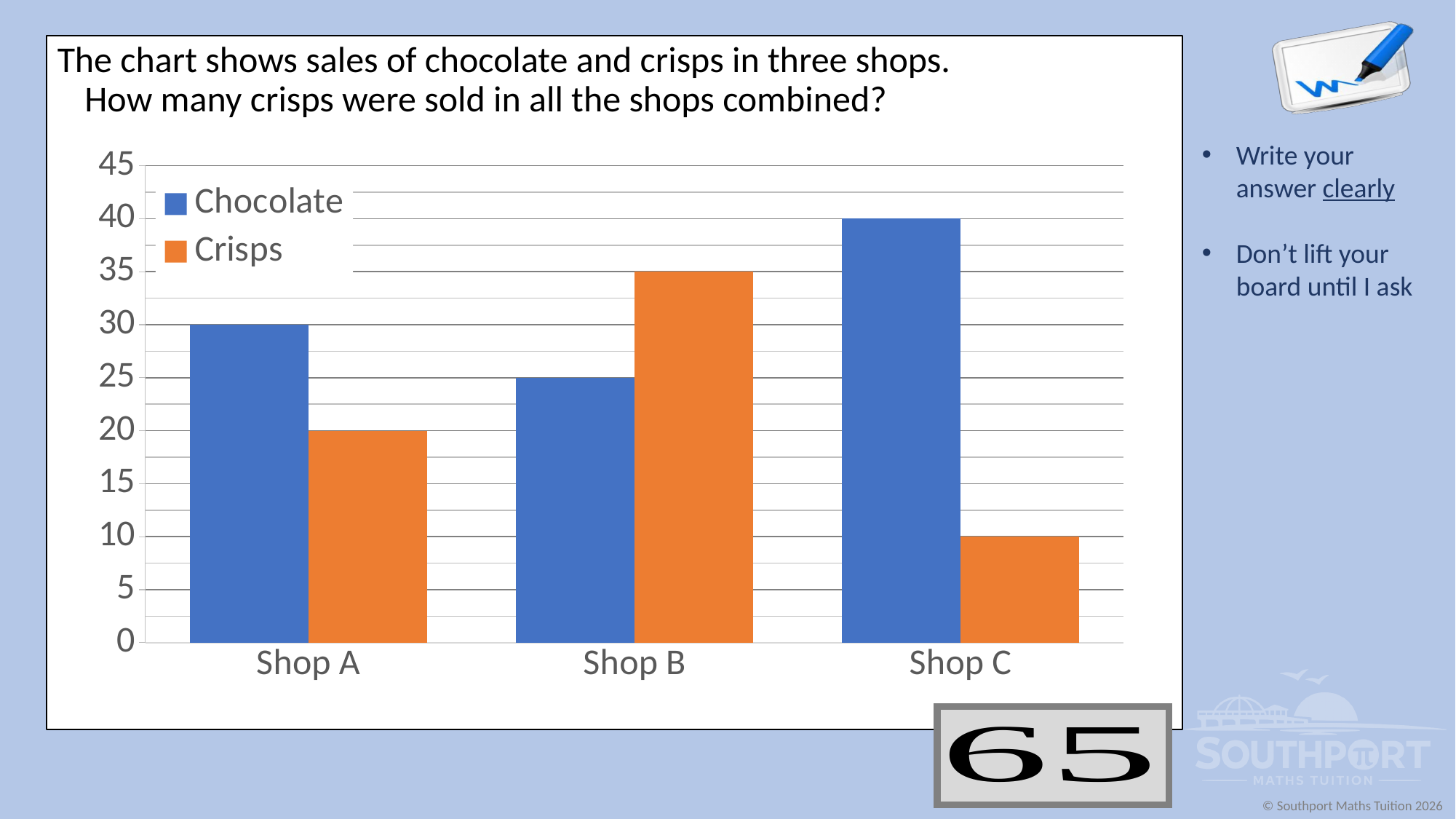
What kind of chart is shown on the slide? bar chart How many series does the legend list? 2 Which shop has the lowest Crisps sales? Shop C Is the Chocolate value for Shop B greater or less than 30? less Which shop has the highest Chocolate sales? Shop C What is the value of the Crisps bar for Shop C? 10 What is the difference between Chocolate and Crisps sales in Shop C? 30 What is the value of the Chocolate bar for Shop A? 30 Which is larger in Shop B, Chocolate sales or Crisps sales? Crisps How many shops are shown on the x axis? 3 What colour are the Crisps bars? orange What is the value of the Crisps bar for Shop B? 35